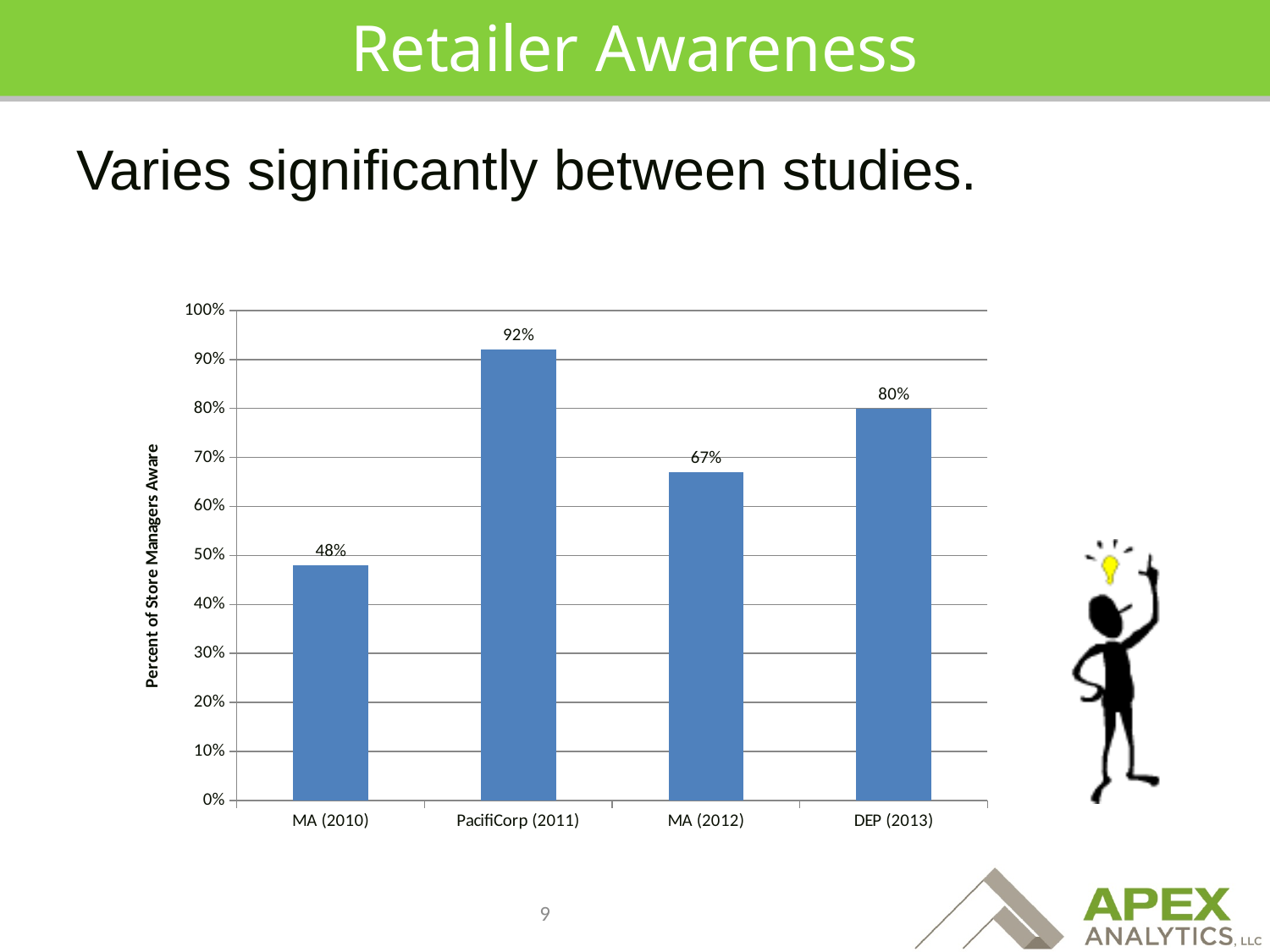
What is the value for DEP (2013)? 80% What is the value for PacifiCorp (2011)? 92% How many studies are shown on the chart? 4 Which study has the lowest percent of store managers aware? MA (2010) What is the value for MA (2010)? 48% Which is larger, the value for DEP (2013) or the value for MA (2012)? DEP (2013) Which study has the highest percent of store managers aware? PacifiCorp (2011) What is the label of the vertical axis? Percent of Store Managers Aware What is the difference between the values for PacifiCorp (2011) and MA (2010)? 44% What kind of chart is shown on the slide? bar chart What is the value for MA (2012)? 67% Is the value for MA (2012) greater or less than 60%? greater